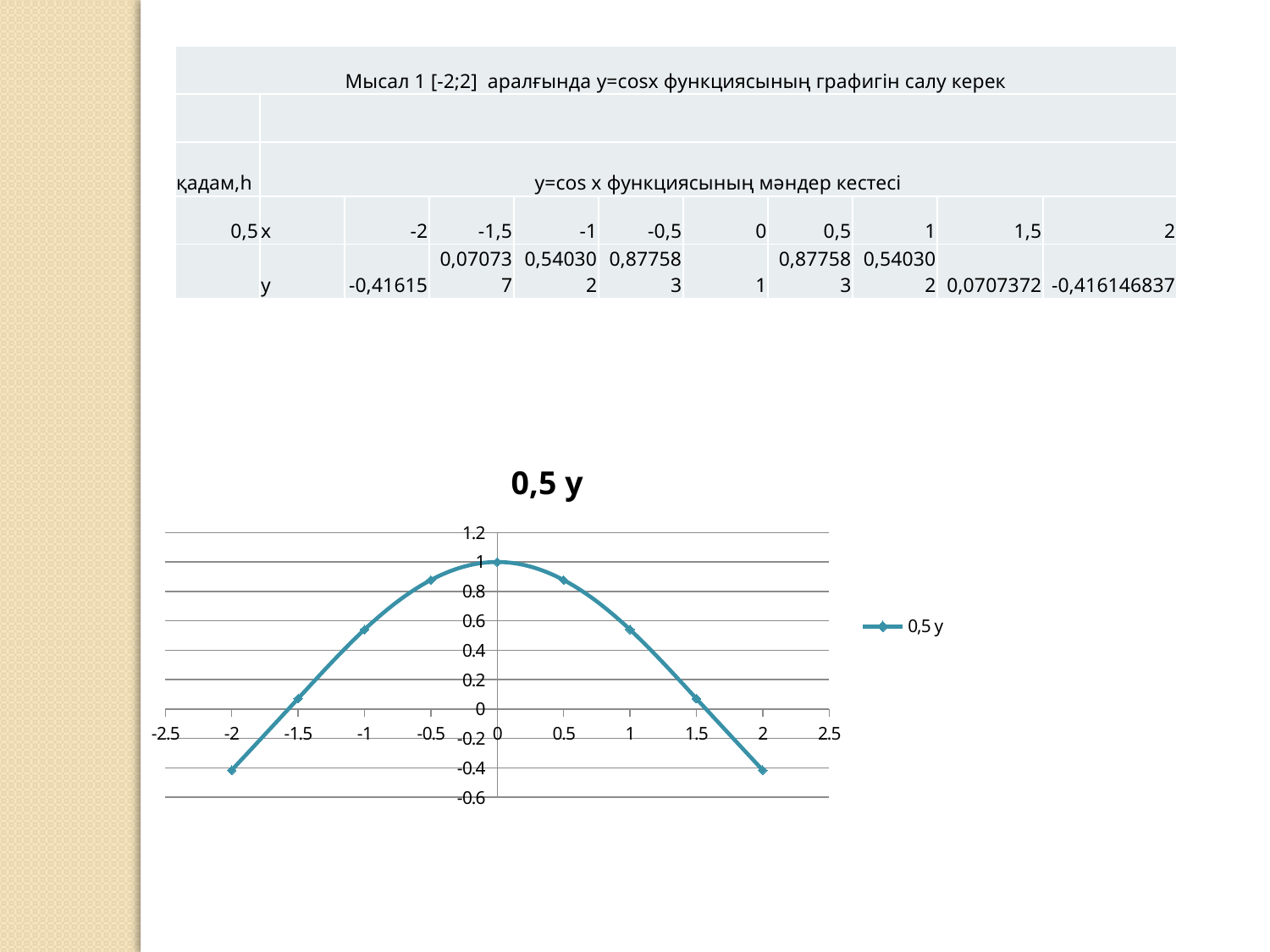
At which x value does the plotted line reach its highest point? 0 What is the value of the plotted series at x = 0? 1 Is the value at x = -0.5 greater or less than 0.8? greater What is the title of the chart? 0,5 y Is the value at x = -2 greater or less than 0? less Do the values rise or fall as x increases from 0 to 2? fall How many data points are plotted on the chart? 9 How many series does the chart legend list? 1 Is the value at x = 1 greater or less than 0.4? greater What type of chart is shown on the slide? line chart Which is larger, the value at x = -1 or the value at x = -1.5? x = -1